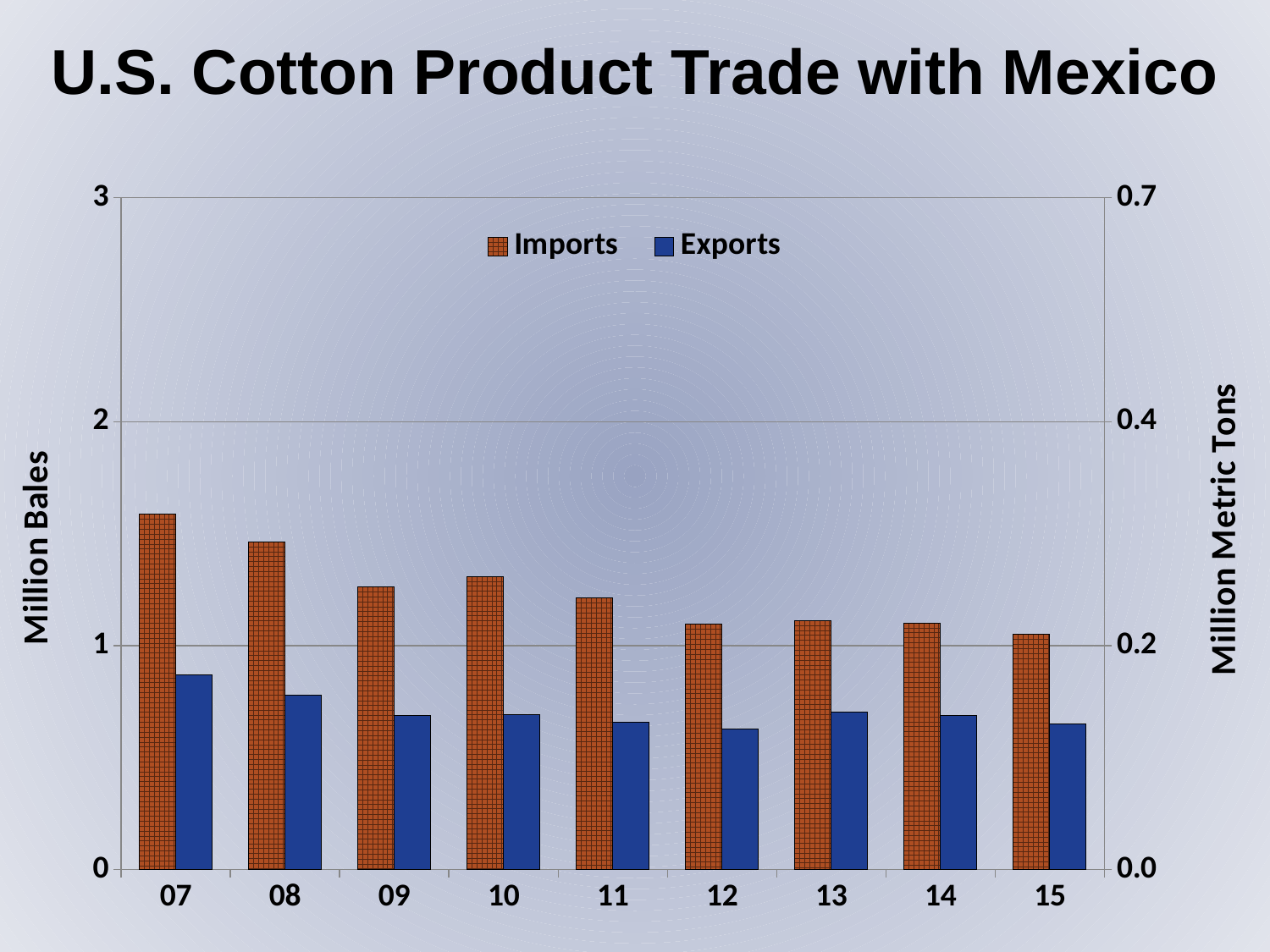
What is the label on the left vertical axis? Million Bales Is the Imports value for 08 greater or less than 1 million bales? greater What kind of chart is shown on the slide? bar chart Which year has the highest Exports value? 07 Which year has the larger Imports value, 07 or 08? 07 Do Imports generally rise or fall from 07 to 15? fall How many series does the legend list? 2 Is the Exports value for 07 greater or less than 1 million bales? less Which is larger in 07, Imports or Exports? Imports Which year has the highest Imports value? 07 Is the Imports value for 07 greater or less than 2 million bales? less How many years are shown on the x axis? 9